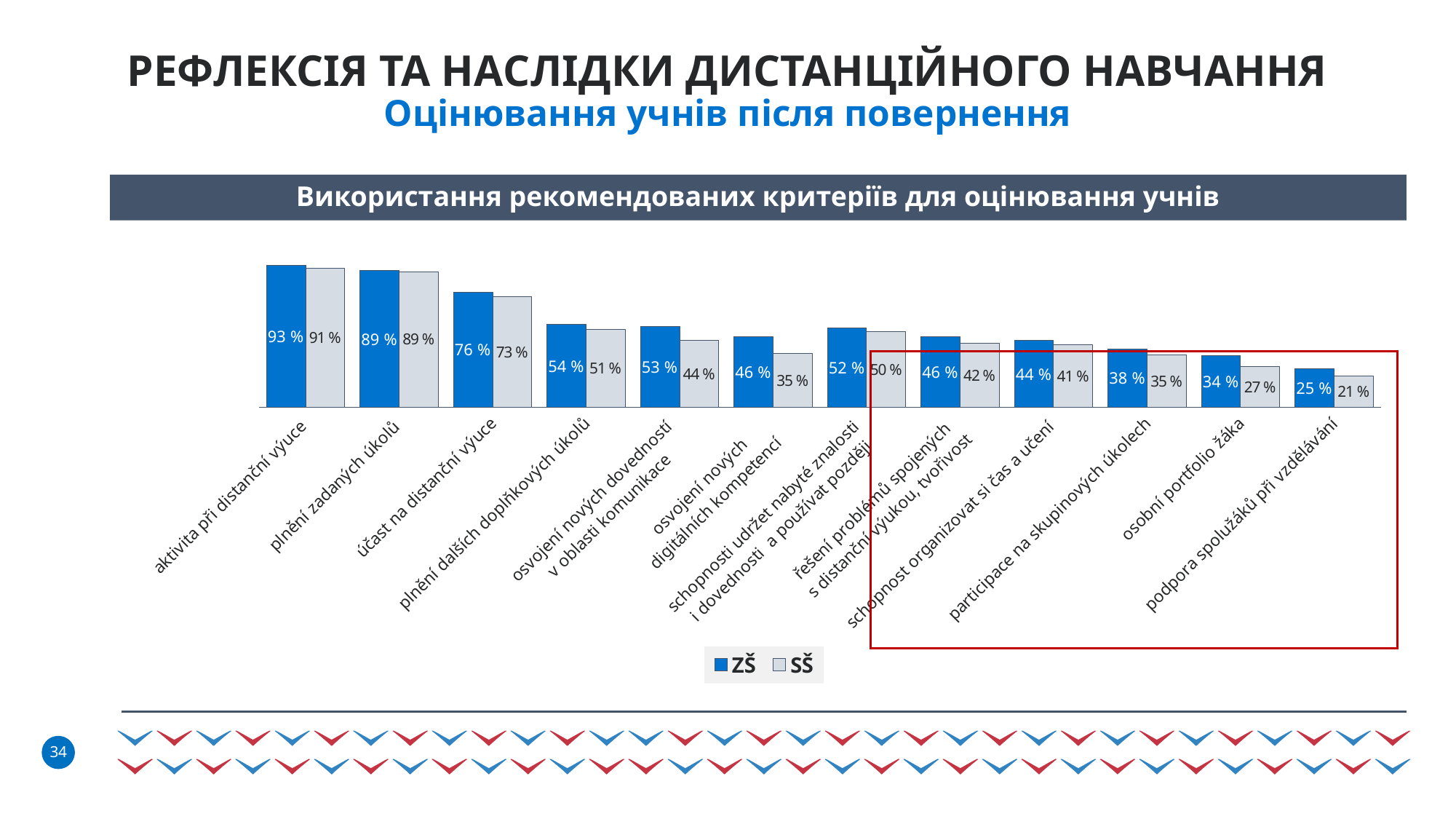
What is the difference between the ZŠ and SŠ values for "osvojení nových dovedností v oblasti komunikace"? 9 % Which is larger for "účast na distanční výuce": the ZŠ value or the SŠ value? ZŠ How many categories are shown on the x axis of the chart? 12 What are the two series named in the legend? ZŠ and SŠ What kind of chart is shown on the slide? bar chart What is the SŠ value for "osobní portfolio žáka"? 27 % What is the ZŠ value for "aktivita při distanční výuce"? 93 % What is the SŠ value for "osvojení nových digitálních kompetencí"? 35 % Which category has the lowest SŠ value? podpora spolužáků při vzdělávání How many series does the legend list? 2 Do the ZŠ values generally rise or fall from left to right along the x axis? fall Which category has the highest ZŠ value? aktivita při distanční výuce